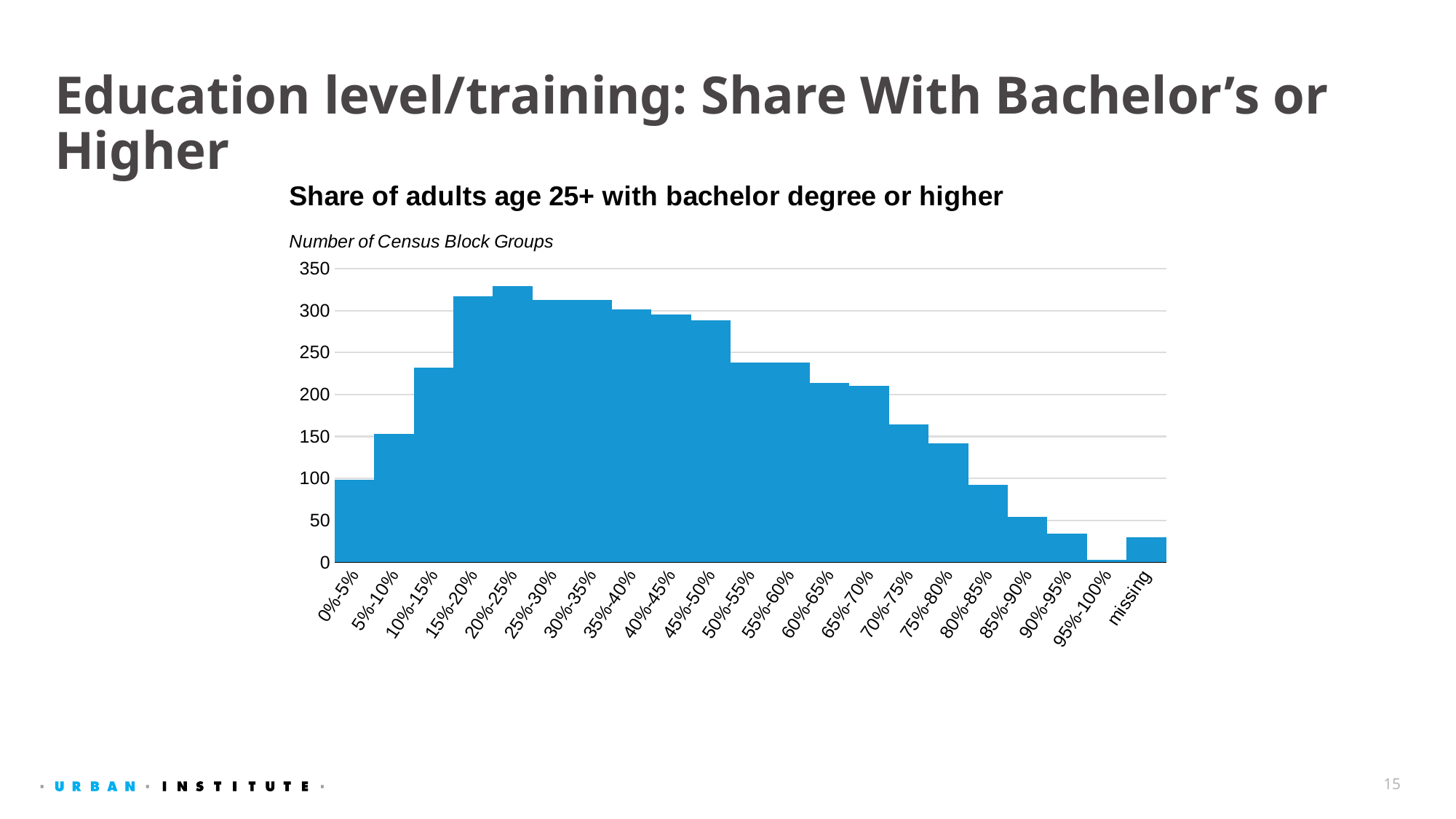
Do the values rise or fall moving from the 20%-25% category to the 95%-100% category? Fall Which has more census block groups, 10%-15% or 75%-80%? 10%-15% How many categories are shown on the x axis? 21 Which category has the highest number of census block groups? 20%-25% What kind of chart is shown on the slide? Bar chart Is the value for 45%-50% greater or less than 250? greater What does the vertical axis of the chart measure? Number of Census Block Groups Is the value for 80%-85% greater or less than 100? less Is the value for 90%-95% greater or less than 50? less Which category has the lowest number of census block groups? 95%-100%